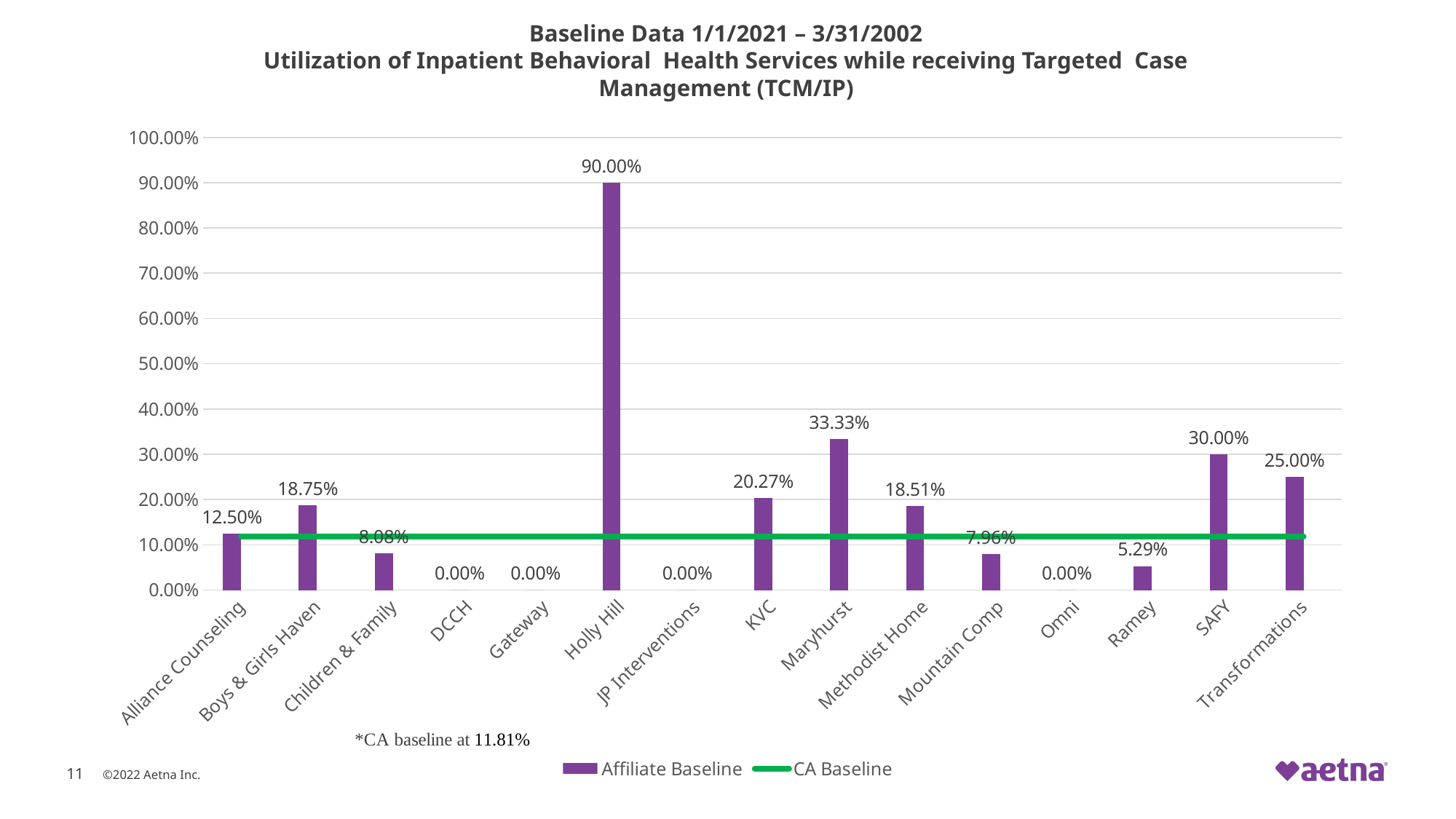
Which has a larger Affiliate Baseline value, KVC or Methodist Home? KVC What is the Affiliate Baseline value for Ramey? 5.29% What is the Affiliate Baseline value for Holly Hill? 90.00% How many affiliates are shown on the x axis? 15 What is the CA baseline value stated in the note below the chart? 11.81% What is the difference between the Affiliate Baseline values for SAFY and Transformations? 5.00% What is the Affiliate Baseline value for Maryhurst? 33.33% What kind of chart is shown on the slide? Bar chart with a line Which affiliate has the highest Affiliate Baseline value? Holly Hill Is the Affiliate Baseline value for Maryhurst greater or less than 30.00%? greater How many affiliates have an Affiliate Baseline value of 0.00%? 4 How many series does the legend list? 2